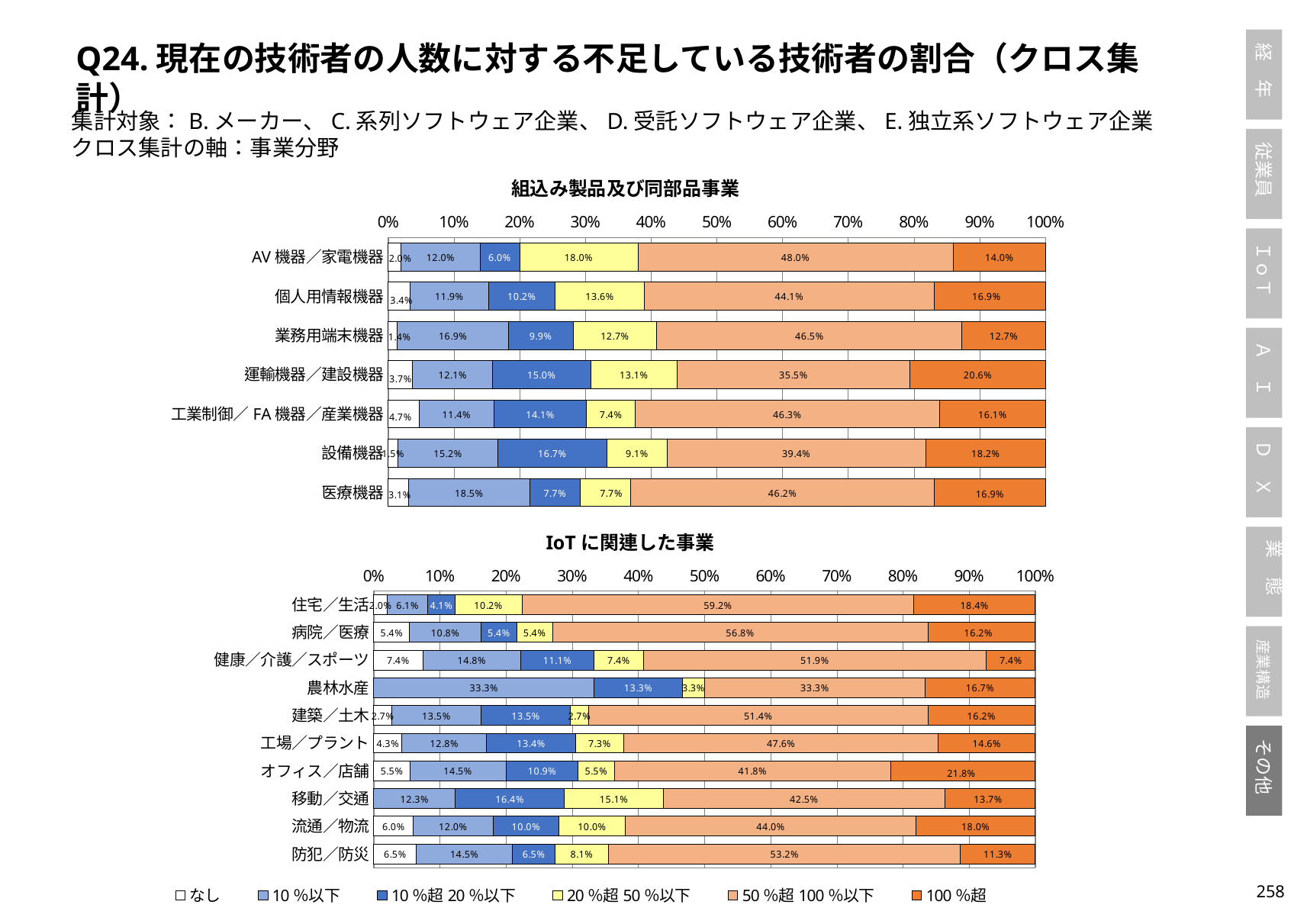
In the chart titled 組込み製品及び同部品事業, how many categories are shown? 7 In the chart titled IoT に関連した事業, what is the value of the 50 %超 100 %以下 segment for 住宅／生活? 59.2% In the chart titled IoT に関連した事業, how many categories are shown? 10 In the chart titled 組込み製品及び同部品事業, which category has the highest value for the 100 %超 segment? 運輸機器／建設機器 What kind of chart is the chart titled 組込み製品及び同部品事業? Stacked bar chart In the chart titled IoT に関連した事業, what is the difference between the 50 %超 100 %以下 values for 住宅／生活 and オフィス／店舗? 17.4% In the chart titled 組込み製品及び同部品事業, what is the value of the 50 %超 100 %以下 segment for AV 機器／家電機器? 48.0% In the chart titled IoT に関連した事業, which category has the highest value for the 100 %超 segment? オフィス／店舗 In the chart titled IoT に関連した事業, what is the value of the 10 %以下 segment for 農林水産? 33.3% In the chart titled 組込み製品及び同部品事業, what is the value of the 100 %超 segment for 運輸機器／建設機器? 20.6% How many series does the legend list? 6 In the chart titled IoT に関連した事業, which category has the lowest value for the 100 %超 segment? 健康／介護／スポーツ